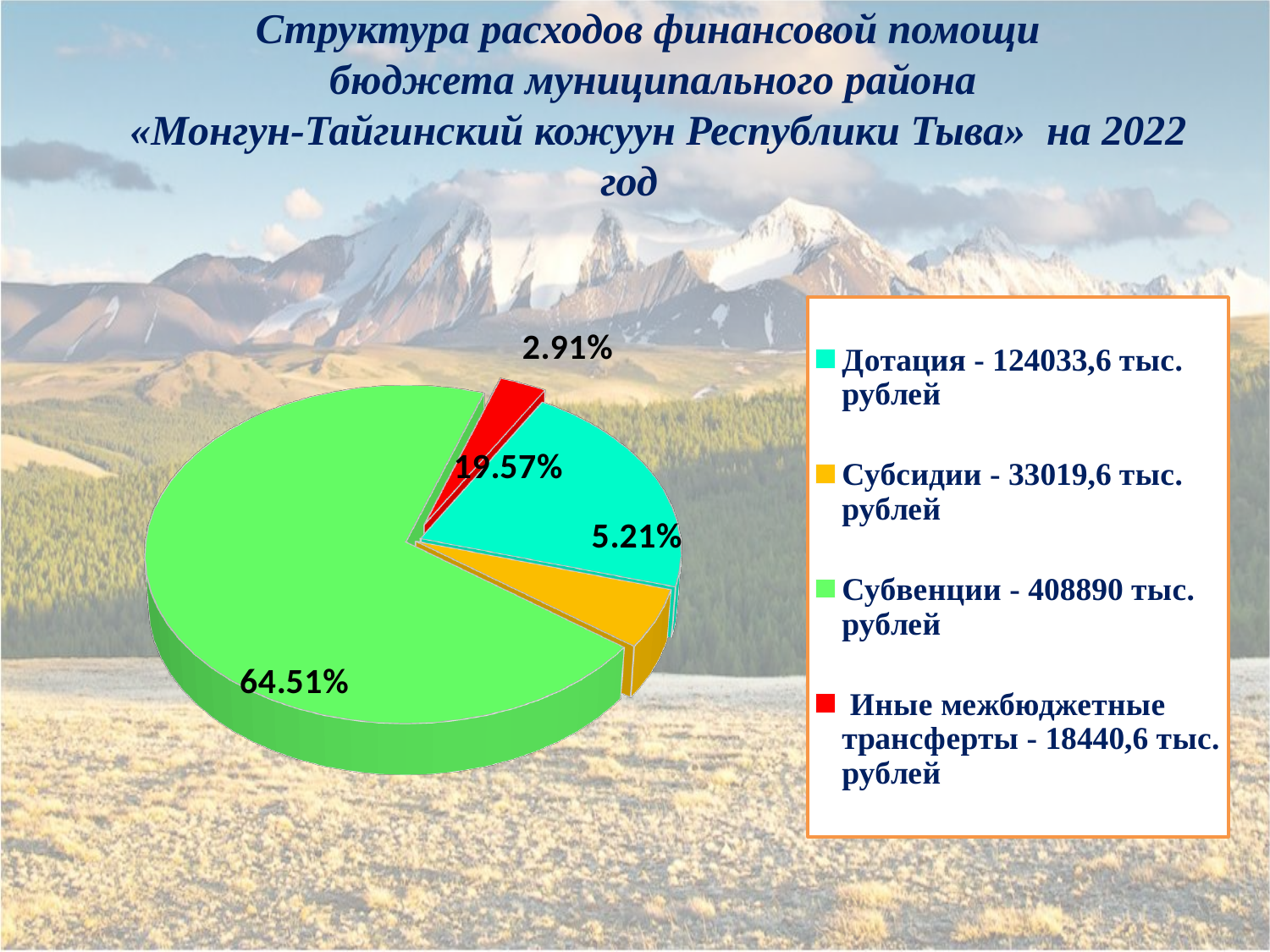
What kind of chart is shown on the slide? pie chart According to the legend, what amount is given for Субсидии? 33019,6 тыс. рублей How many slices does the pie chart have? 4 Which category has the smallest slice of the pie? Иные межбюджетные трансферты Which category has the largest slice of the pie? Субвенции What share of the pie does Дотация take? 19.57% What share of the pie does Иные межбюджетные трансферты take? 2.91% How many entries does the legend list? 4 What share of the pie does Субвенции take? 64.51% What is the difference in percentage points between the Субвенции slice and the Дотация slice? 44.94% Which is larger, the Субсидии slice or the Дотация slice? Дотация